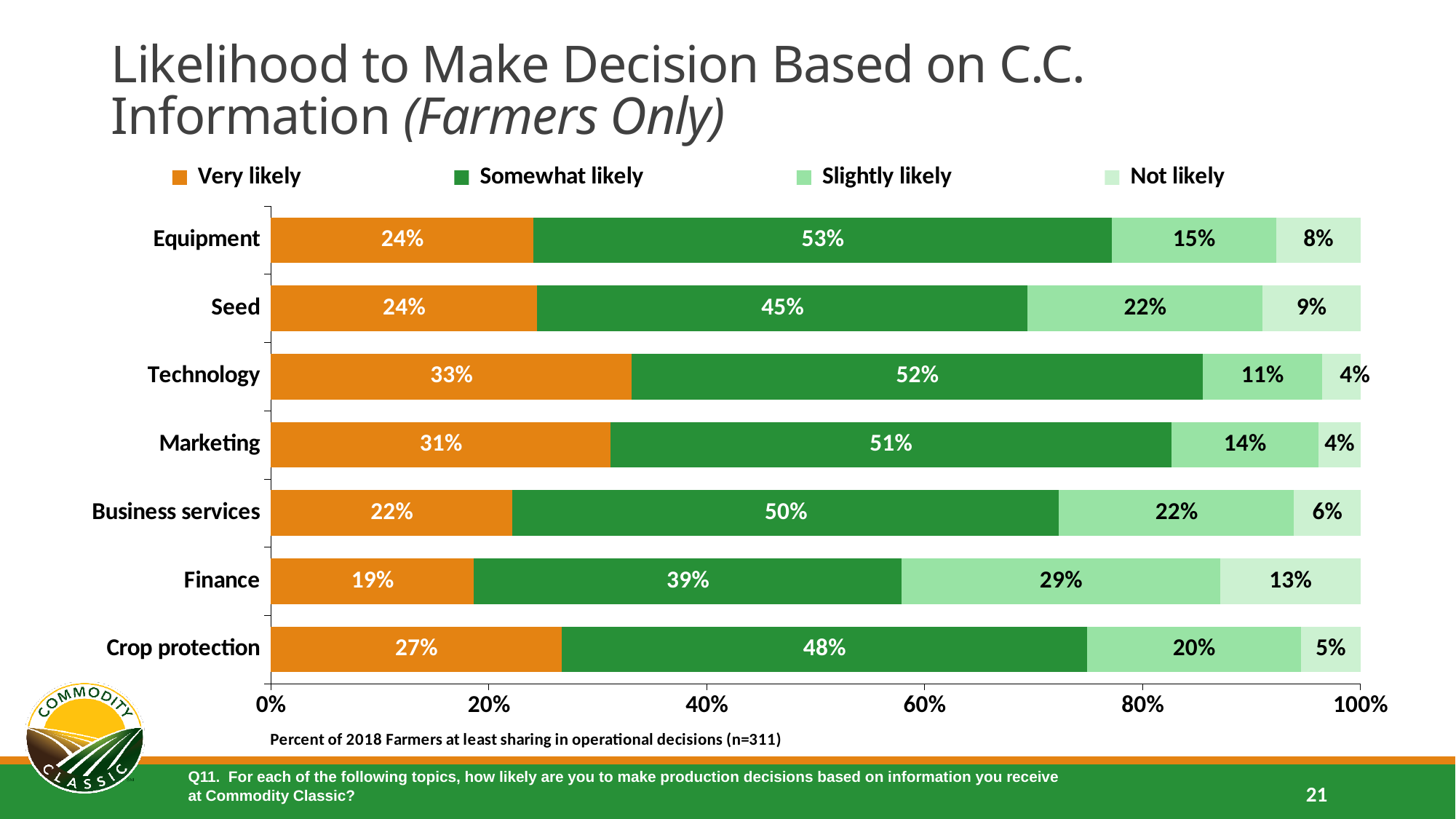
How many topics are shown on the chart? 7 What is the "Not likely" value for Finance? 13% What percentage of farmers are "Very likely" to make a decision based on C.C. information for Technology? 33% Is the combined "Very likely" and "Somewhat likely" share for Finance greater or less than 60%? less How many series does the legend list? 4 What kind of chart is shown on the slide? Stacked bar chart Which topic has the highest "Slightly likely" percentage? Finance What is the "Somewhat likely" value for Crop protection? 48% Which has a larger "Very likely" value, Marketing or Crop protection? Marketing What is the difference between the "Somewhat likely" values for Equipment and Finance? 14 percentage points Which topic has the lowest "Somewhat likely" percentage? Finance Which topic has the highest "Very likely" percentage? Technology